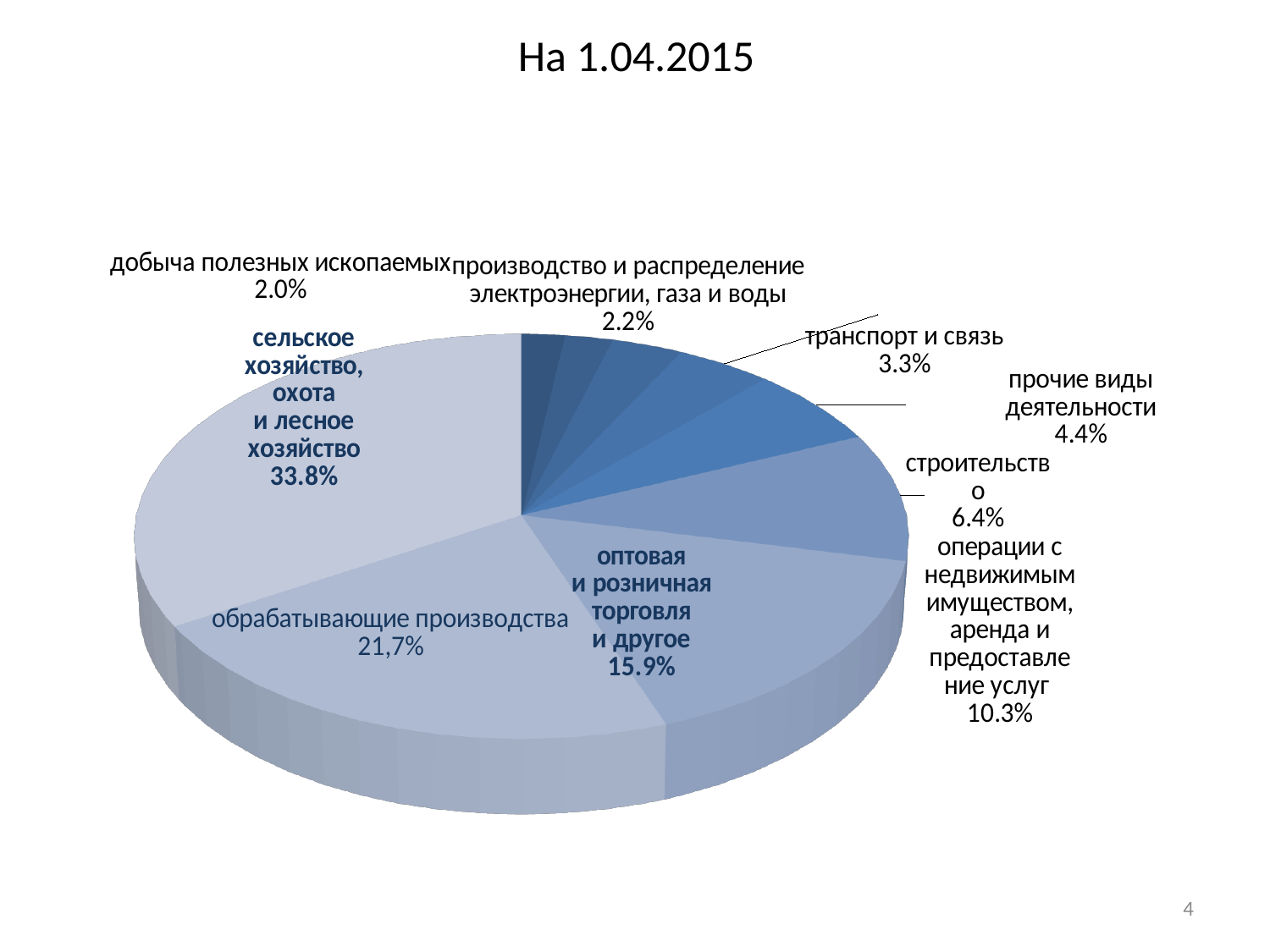
What share does транспорт и связь have in the pie chart? 3.3% Which is larger: the share for оптовая и розничная торговля и другое or the share for операции с недвижимым имуществом, аренда и предоставление услуг? оптовая и розничная торговля и другое Which category has the smallest slice in the pie chart? добыча полезных ископаемых What is the difference in percentage points between the share for строительство and the share for прочие виды деятельности? 2.0 Which category has the largest slice in the pie chart? сельское хозяйство, охота и лесное хозяйство What share does производство и распределение электроэнергии, газа и воды have in the pie chart? 2.2% What kind of chart is shown on the slide? pie chart How many slices does the pie chart have? 9 What share does обрабатывающие производства have in the pie chart? 21,7% What is the title of the chart on the slide? На 1.04.2015 What share does строительство have in the pie chart? 6.4% What share does сельское хозяйство, охота и лесное хозяйство have in the pie chart? 33.8%